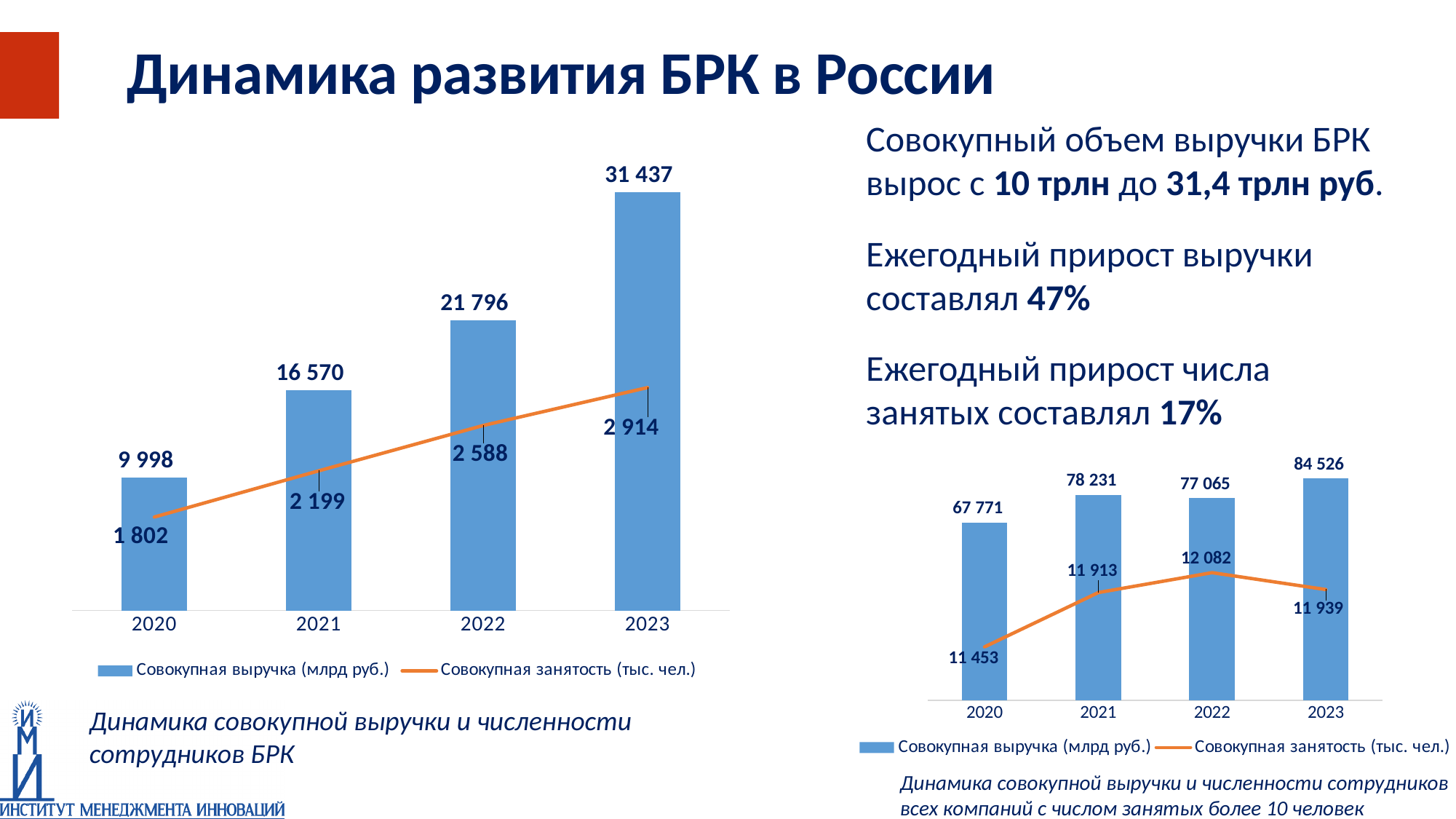
In the right chart, what is the value of Совокупная занятость for 2022? 12 082 How many years are shown on the x axis of the right chart? 4 What type of chart is used for Совокупная выручка in the left chart? bar chart In the right chart (all companies with more than 10 employees), what is the value of Совокупная выручка for 2021? 78 231 In the left chart, what is the value of Совокупная занятость (тыс. чел.) for 2021? 2 199 In the left chart (Динамика совокупной выручки и численности сотрудников БРК), what is the value of Совокупная выручка (млрд руб.) for 2023? 31 437 In the left chart, what is the difference in Совокупная выручка between 2023 and 2022? 9 641 In the left chart, which year has the lowest Совокупная выручка? 2020 In the left chart, does Совокупная занятость rise or fall from 2020 to 2023? rise How many series does the legend of the left chart list? 2 In the right chart, which is larger: Совокупная выручка in 2021 or in 2022? 2021 In the right chart, which year has the highest Совокупная занятость? 2022